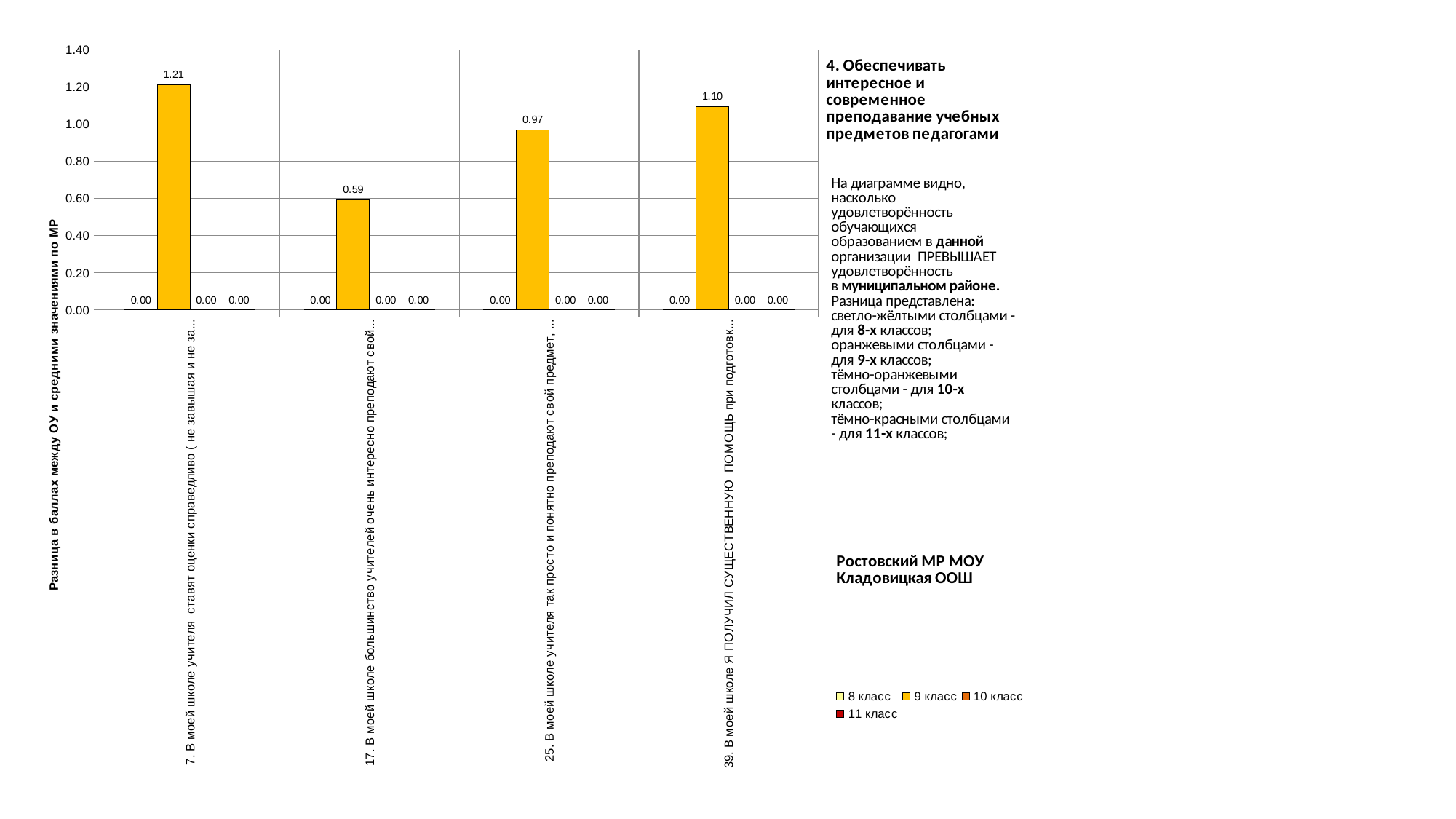
What kind of chart is shown on the slide? Bar chart How many series does the legend list? 4 What is the value of the 9 класс bar for category 7 (В моей школе учителя ставят оценки справедливо)? 1.21 Which category has the highest 9 класс value? 7. В моей школе учителя ставят оценки справедливо What is the value of the 9 класс bar for category 25 (учителя так просто и понятно преподают свой предмет)? 0.97 What is the difference between the 9 класс values for category 7 and category 17? 0.62 What is the value of the 8 класс series for category 7? 0.00 How many categories are shown on the x axis? 4 What is the value of the 9 класс bar for category 17 (большинство учителей очень интересно преподают)? 0.59 Which category has the lowest 9 класс value? 17. В моей школе большинство учителей очень интересно преподают свой предмет Which is larger: the 9 класс value for category 25 or for category 39? Category 39 (1.10) What is the value of the 9 класс bar for category 39 (Я ПОЛУЧИЛ СУЩЕСТВЕННУЮ ПОМОЩЬ при подготовке)? 1.10